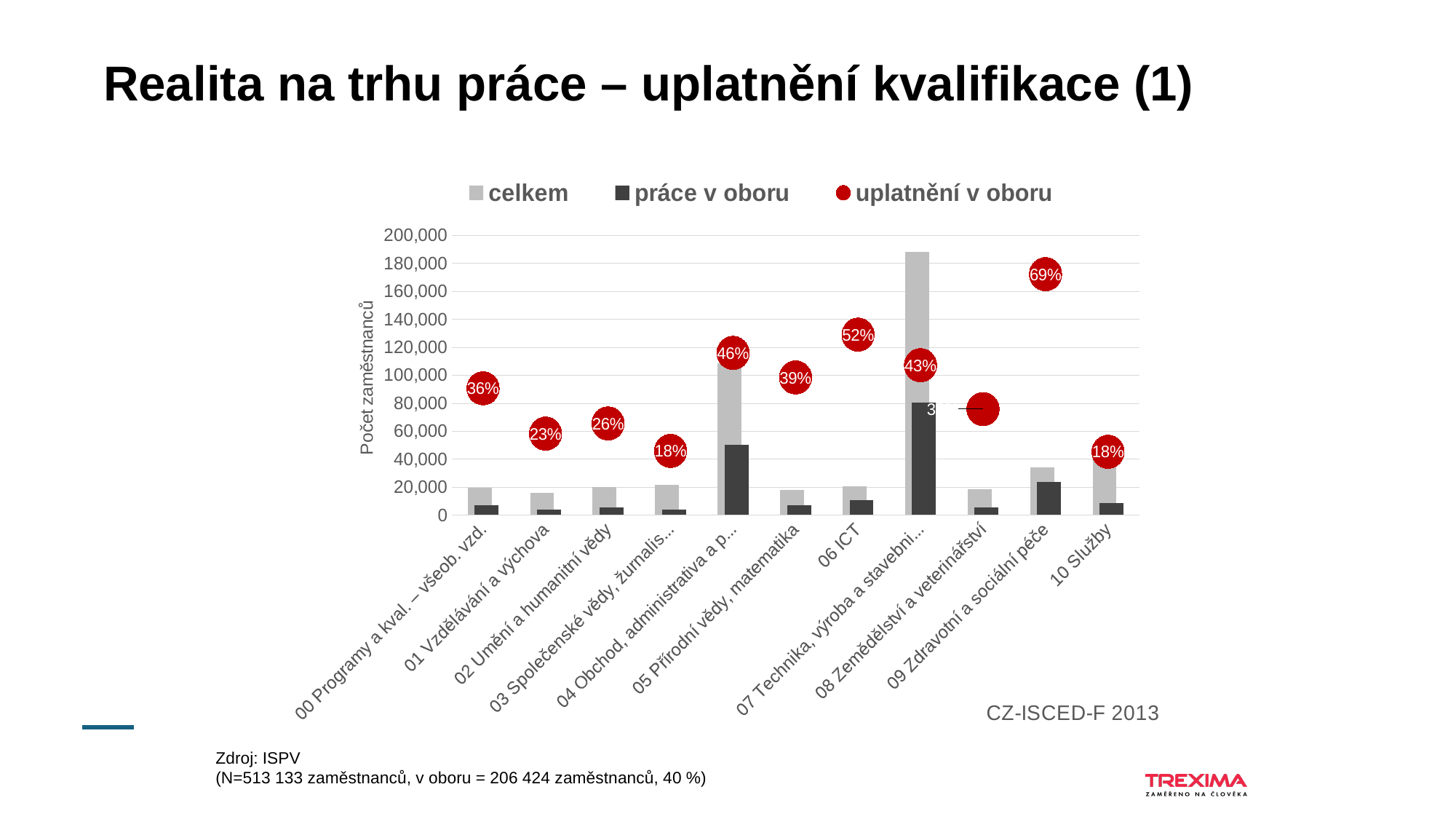
What is the 'uplatnění v oboru' value for 09 Zdravotní a sociální péče? 69% Which has a larger 'celkem' bar: 04 Obchod, administrativa a p... or 06 ICT? 04 Obchod, administrativa a p... What is the difference in 'uplatnění v oboru' between 09 Zdravotní a sociální péče and 00 Programy a kval. – všeob. vzd.? 33 percentage points How many series does the legend list? 3 Which category has the highest 'uplatnění v oboru' percentage? 09 Zdravotní a sociální péče What is the label of the vertical axis? Počet zaměstnanců Is the 'celkem' value for 07 Technika, výroba a stavebni... greater or less than 160,000? greater Is the 'celkem' value for 04 Obchod, administrativa a p... greater or less than 100,000? greater What is the 'uplatnění v oboru' value for 06 ICT? 52% Which category has the tallest 'celkem' bar? 07 Technika, výroba a stavebni... What is the 'uplatnění v oboru' value for 01 Vzdělávání a výchova? 23% What is the 'uplatnění v oboru' value for 04 Obchod, administrativa a p...? 46%